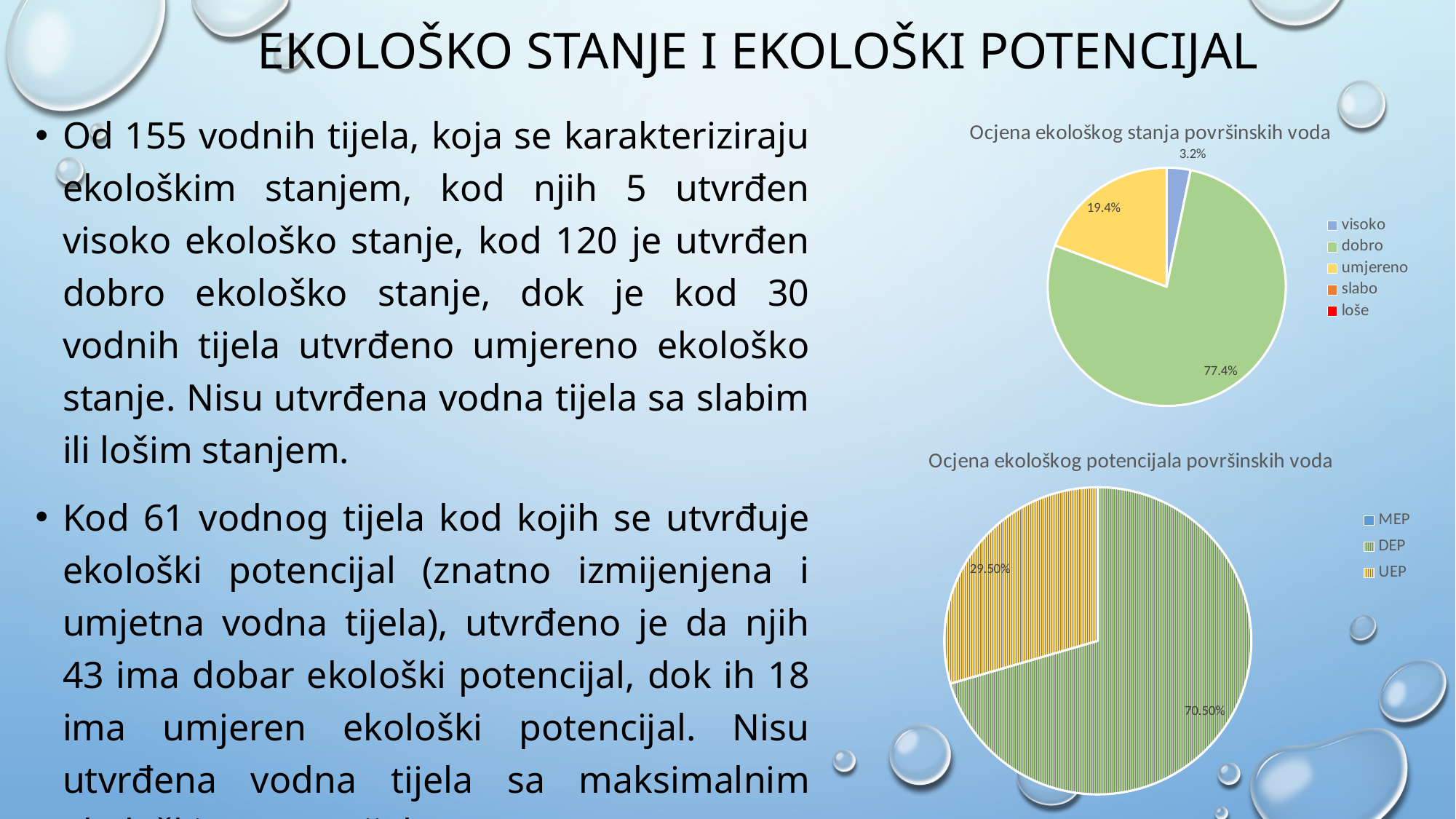
What type of chart is 'Ocjena ekološkog potencijala površinskih voda'? pie chart In the chart titled 'Ocjena ekološkog potencijala površinskih voda', what share does the 'UEP' slice have? 29.50% In the chart titled 'Ocjena ekološkog potencijala površinskih voda', what share does the 'DEP' slice have? 70.50% In the chart titled 'Ocjena ekološkog stanja površinskih voda', how many entries does the legend list? 5 In the chart titled 'Ocjena ekološkog stanja površinskih voda', what is the difference between the 'dobro' and 'umjereno' shares? 58.0 percentage points In the chart titled 'Ocjena ekološkog stanja površinskih voda', what share does the 'dobro' slice have? 77.4% In the chart titled 'Ocjena ekološkog potencijala površinskih voda', how many entries does the legend list? 3 In the chart titled 'Ocjena ekološkog stanja površinskih voda', what share does the 'umjereno' slice have? 19.4% In the chart titled 'Ocjena ekološkog potencijala površinskih voda', which is larger, DEP or UEP? DEP In the chart titled 'Ocjena ekološkog stanja površinskih voda', what share does the 'visoko' slice have? 3.2% In the chart titled 'Ocjena ekološkog stanja površinskih voda', what colour is the 'umjereno' slice? yellow In the chart titled 'Ocjena ekološkog stanja površinskih voda', which category has the largest slice? dobro